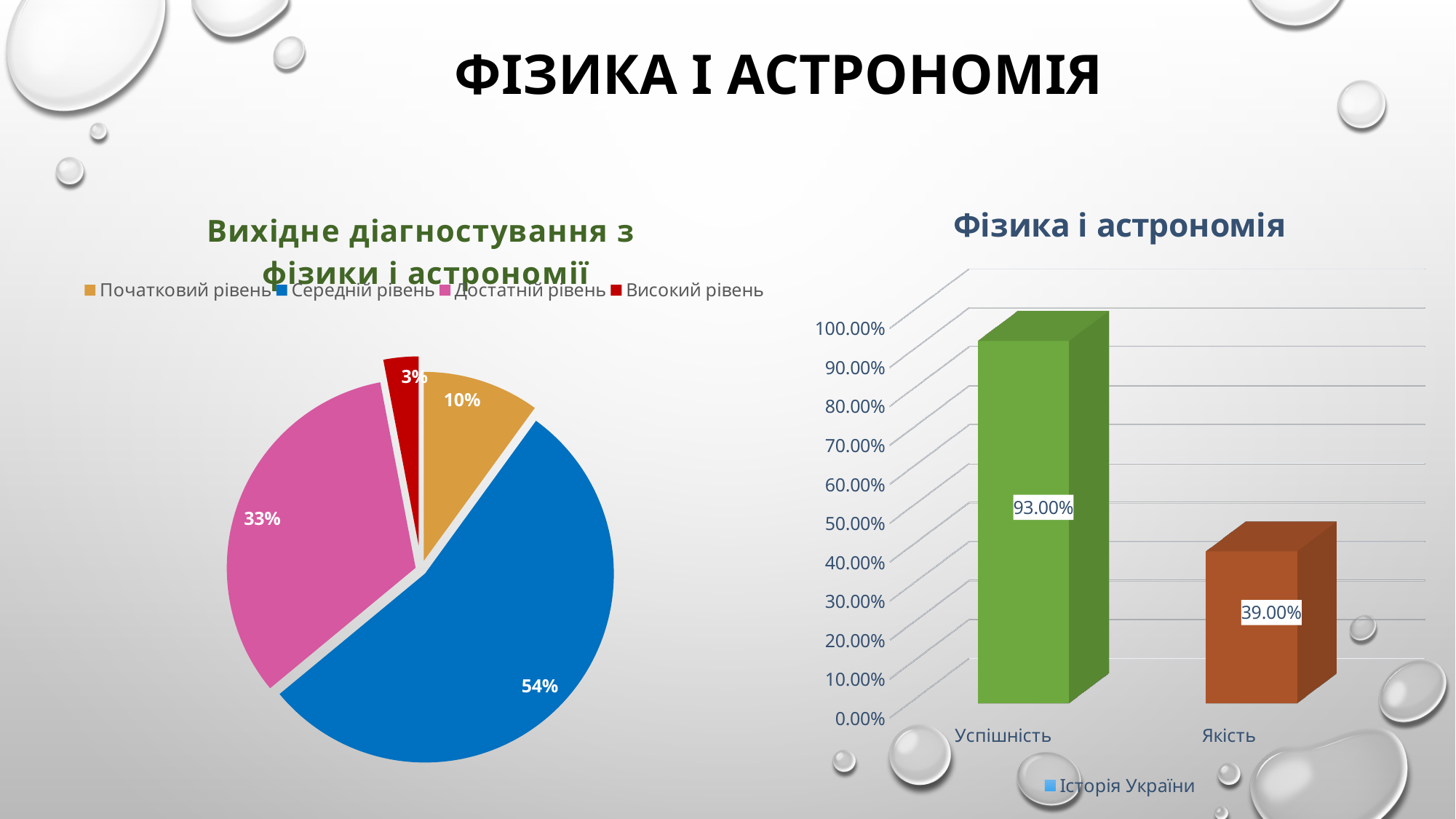
In the pie chart 'Вихідне діагностування з фізики і астрономії', which level has the smallest slice? Високий рівень In the pie chart 'Вихідне діагностування з фізики і астрономії', how many slices are there? 4 What kind of chart is the chart titled 'Фізика і астрономія' on the right? Bar chart In the bar chart 'Фізика і астрономія', what entry does the legend list? Історія України In the pie chart 'Вихідне діагностування з фізики і астрономії', what share is labelled for Достатній рівень? 33% In the pie chart 'Вихідне діагностування з фізики і астрономії', what is the difference between the Достатній рівень and Початковий рівень shares? 23% In the pie chart 'Вихідне діагностування з фізики і астрономії', what share is labelled for Високий рівень? 3% In the pie chart 'Вихідне діагностування з фізики і астрономії', what share is labelled for Середній рівень? 54% In the bar chart 'Фізика і астрономія', what is the value for Якість? 39.00% In the pie chart 'Вихідне діагностування з фізики і астрономії', which level has the largest slice? Середній рівень In the bar chart 'Фізика і астрономія', what is the difference between Успішність and Якість? 54.00% In the bar chart 'Фізика і астрономія', what is the value for Успішність? 93.00%